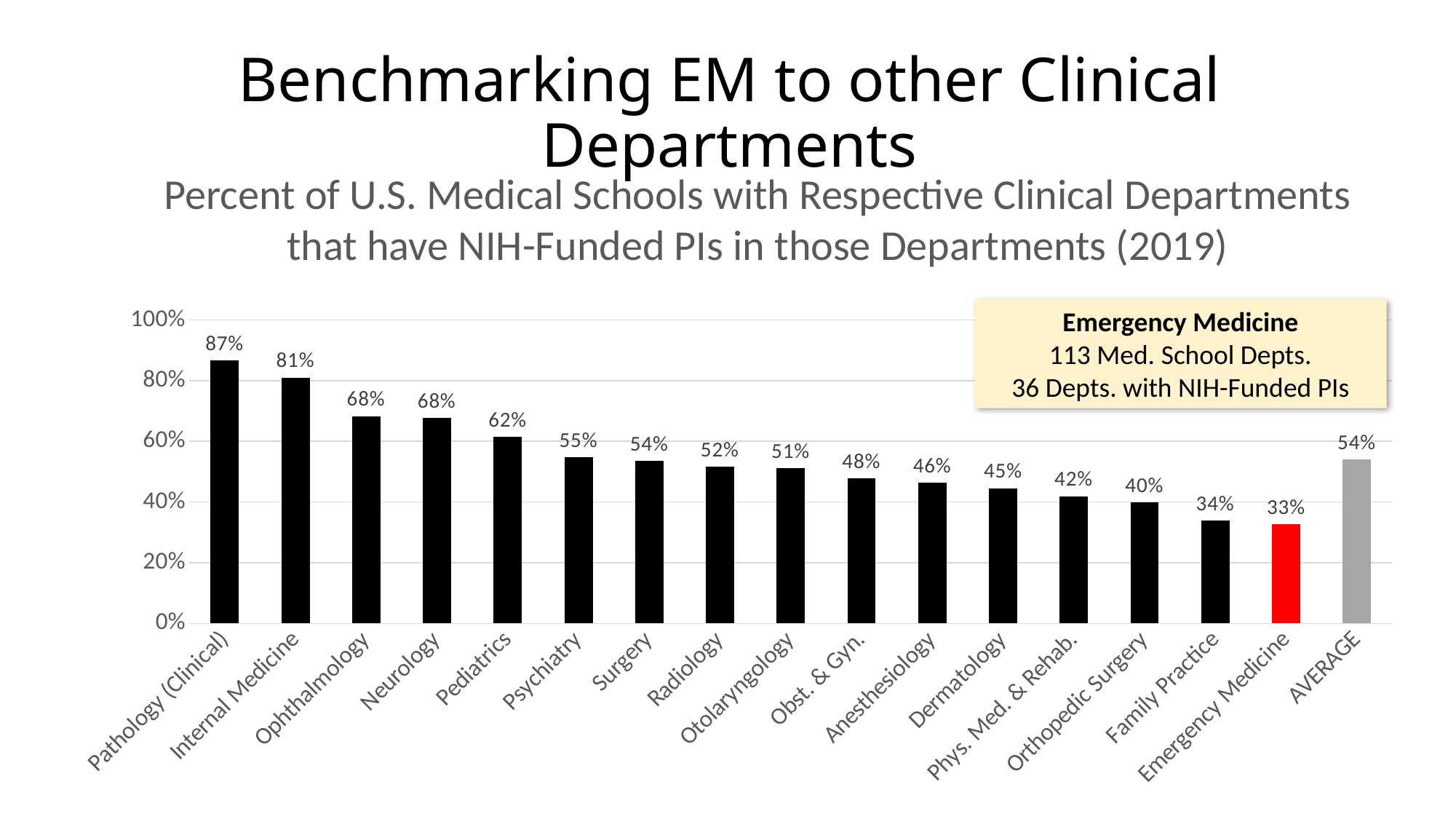
What value is shown for the AVERAGE bar? 54% What type of chart is shown? bar chart Which bar is coloured red? Emergency Medicine What is the difference between Pathology (Clinical) and Emergency Medicine? 54% What is the difference between the AVERAGE and Emergency Medicine? 21% What percent is shown for Emergency Medicine? 33% How many bars are shown in the chart, including AVERAGE? 17 What is the value for Pediatrics? 62% Is the value for Internal Medicine greater or less than 80%? greater Which is larger, Dermatology or Orthopedic Surgery? Dermatology Which department has the lowest percentage? Emergency Medicine Which department has the highest percentage? Pathology (Clinical)